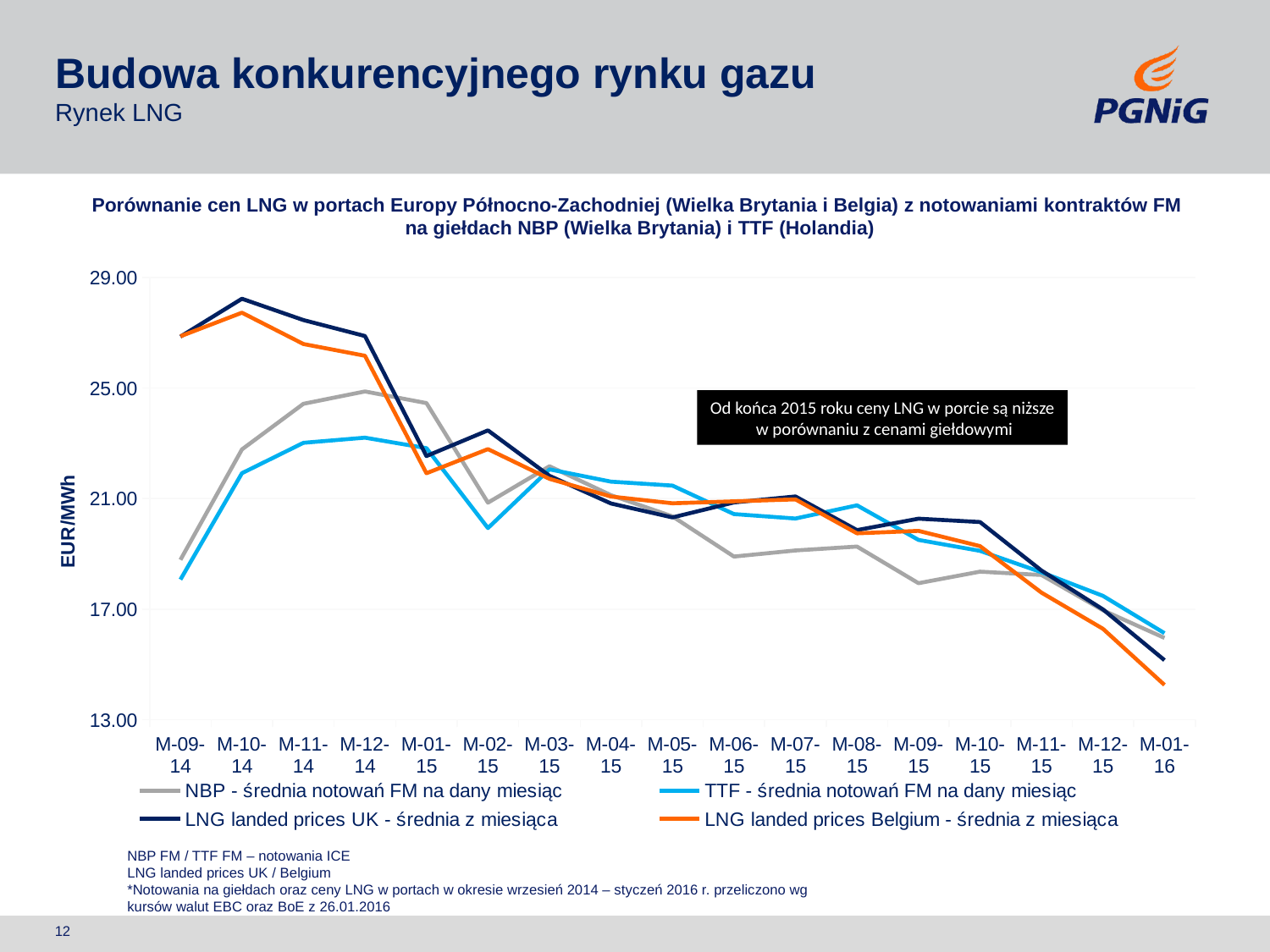
How many series does the legend list? 4 Is the value for LNG landed prices Belgium in M-01-16 greater or less than 17.00? less What unit is shown on the y axis label? EUR/MWh In M-02-15, which is higher: LNG landed prices UK or TTF? LNG landed prices UK How many months are plotted along the x axis? 17 In which month does the LNG landed prices UK series reach its highest value? M-10-14 Do the LNG landed prices UK values overall rise or fall from M-09-14 to M-01-16? fall Is the value for NBP in M-09-14 greater or less than 17.00? greater Which series has the lowest value in M-01-16? LNG landed prices Belgium - średnia z miesiąca Is the value for LNG landed prices UK in M-10-14 greater or less than 25.00? greater What kind of chart is shown on the slide? line chart